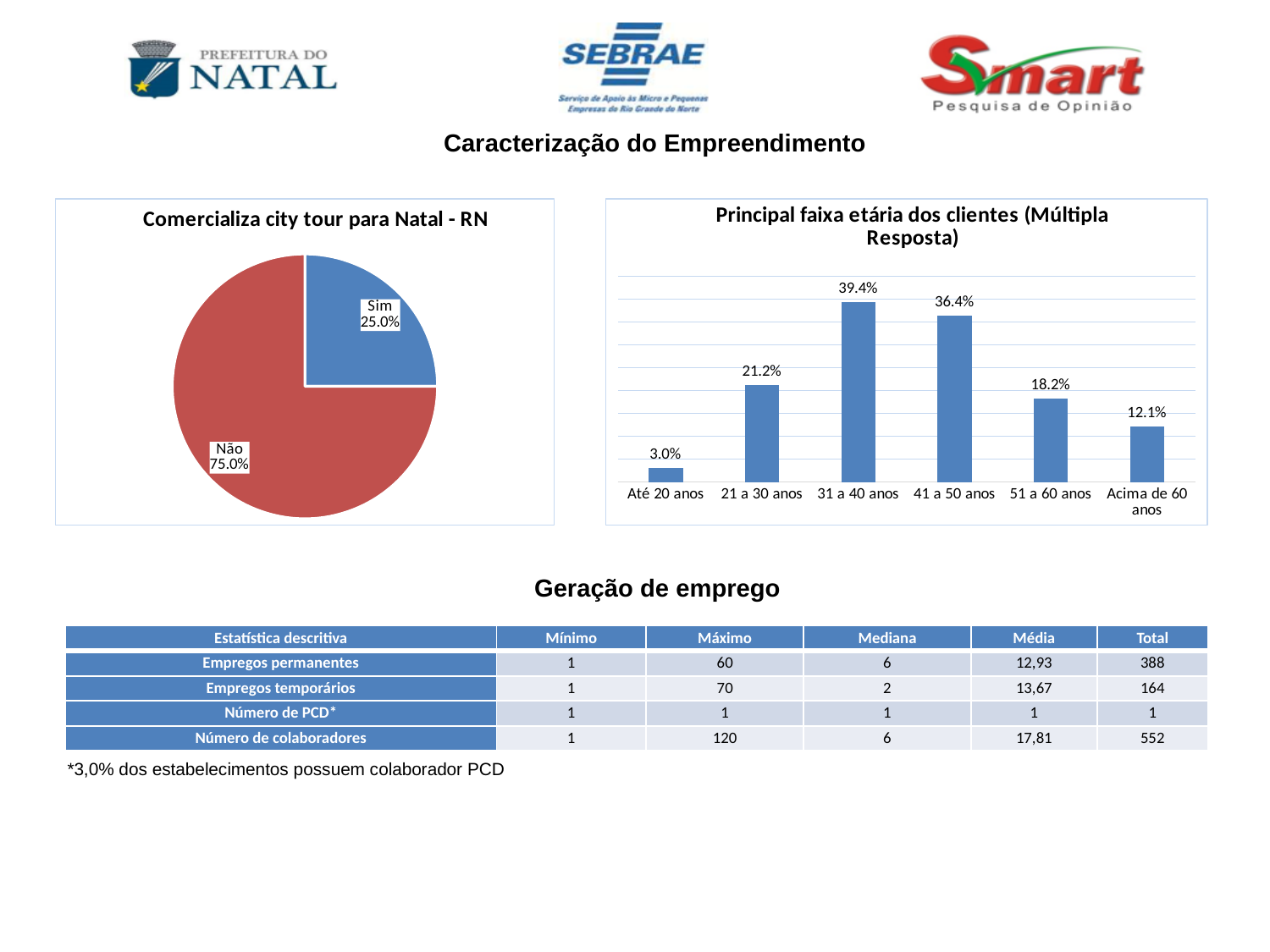
In the chart 'Principal faixa etária dos clientes (Múltipla Resposta)', what is the value for '31 a 40 anos'? 39.4% In the chart 'Comercializa city tour para Natal - RN', how many slices does the pie have? 2 In the chart 'Comercializa city tour para Natal - RN', what share of the pie is 'Não'? 75.0% What kind of chart is 'Principal faixa etária dos clientes (Múltipla Resposta)'? Bar chart In the chart 'Principal faixa etária dos clientes (Múltipla Resposta)', what is the difference between '41 a 50 anos' and '51 a 60 anos'? 18.2% In the chart 'Principal faixa etária dos clientes (Múltipla Resposta)', which is larger: '21 a 30 anos' or '51 a 60 anos'? 21 a 30 anos In the chart 'Principal faixa etária dos clientes (Múltipla Resposta)', how many age groups are shown? 6 In the chart 'Comercializa city tour para Natal - RN', what is the value for 'Sim'? 25.0% In the chart 'Principal faixa etária dos clientes (Múltipla Resposta)', which age group has the lowest value? Até 20 anos What kind of chart is 'Comercializa city tour para Natal - RN'? Pie chart In the chart 'Principal faixa etária dos clientes (Múltipla Resposta)', what is the value for 'Acima de 60 anos'? 12.1% In the chart 'Principal faixa etária dos clientes (Múltipla Resposta)', which age group has the highest value? 31 a 40 anos